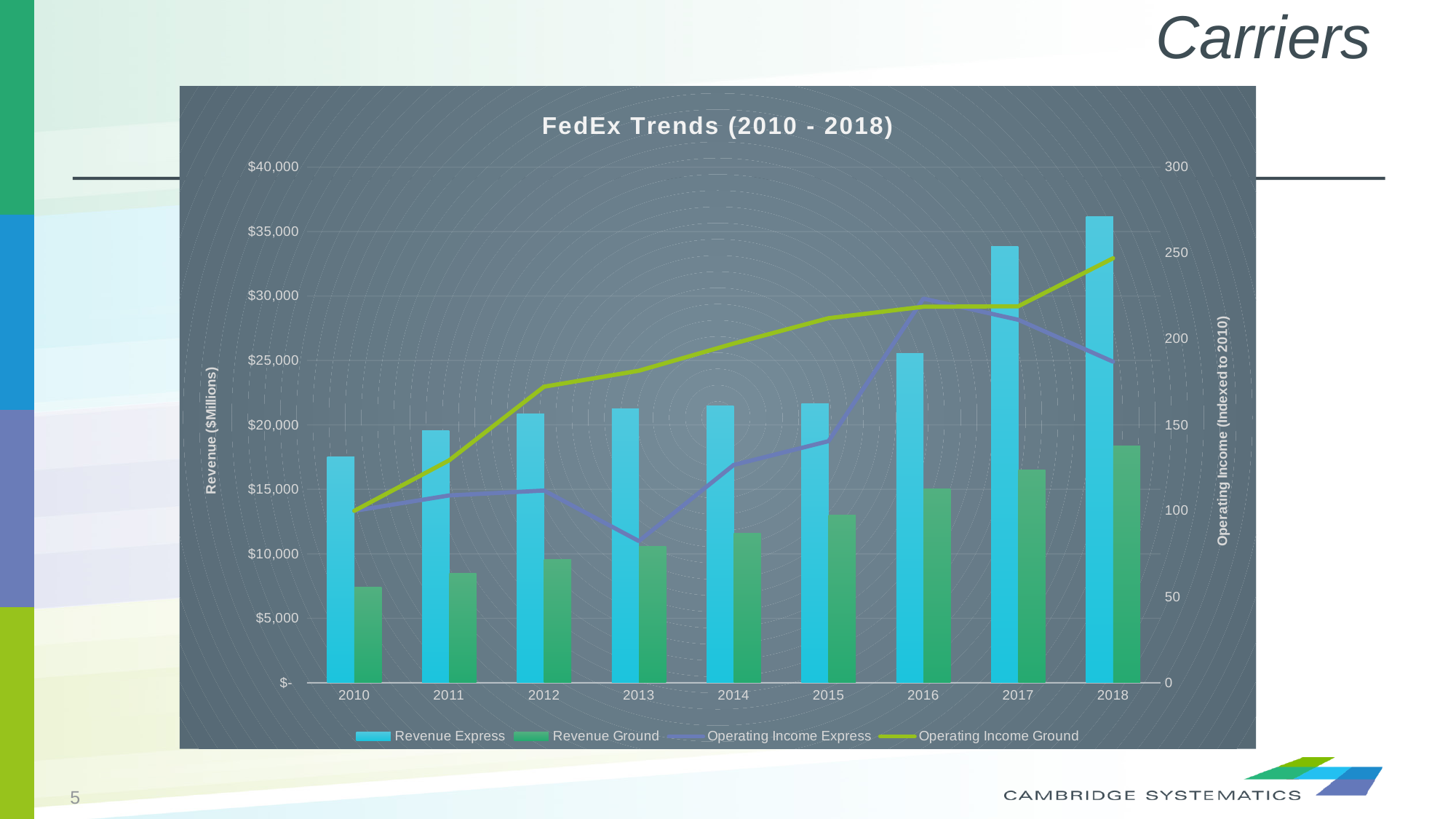
In 2018, which is larger: Revenue Express or Revenue Ground? Revenue Express How many series does the chart's legend list? 4 In which year is Revenue Express highest? 2018 In which year is Revenue Ground lowest? 2010 What is the title of the chart? FedEx Trends (2010 - 2018) Is the Revenue Ground value for 2010 greater or less than $10,000? less Is the Operating Income Ground value for 2018 greater or less than 200? greater Is the Revenue Express value for 2018 greater or less than $35,000? greater What kind of chart is shown on the slide? Combined bar and line chart Which series are plotted as lines in the chart? Operating Income Express and Operating Income Ground How many years are shown on the x axis of the chart? 9 Does Revenue Ground rise or fall from 2010 to 2018? rise